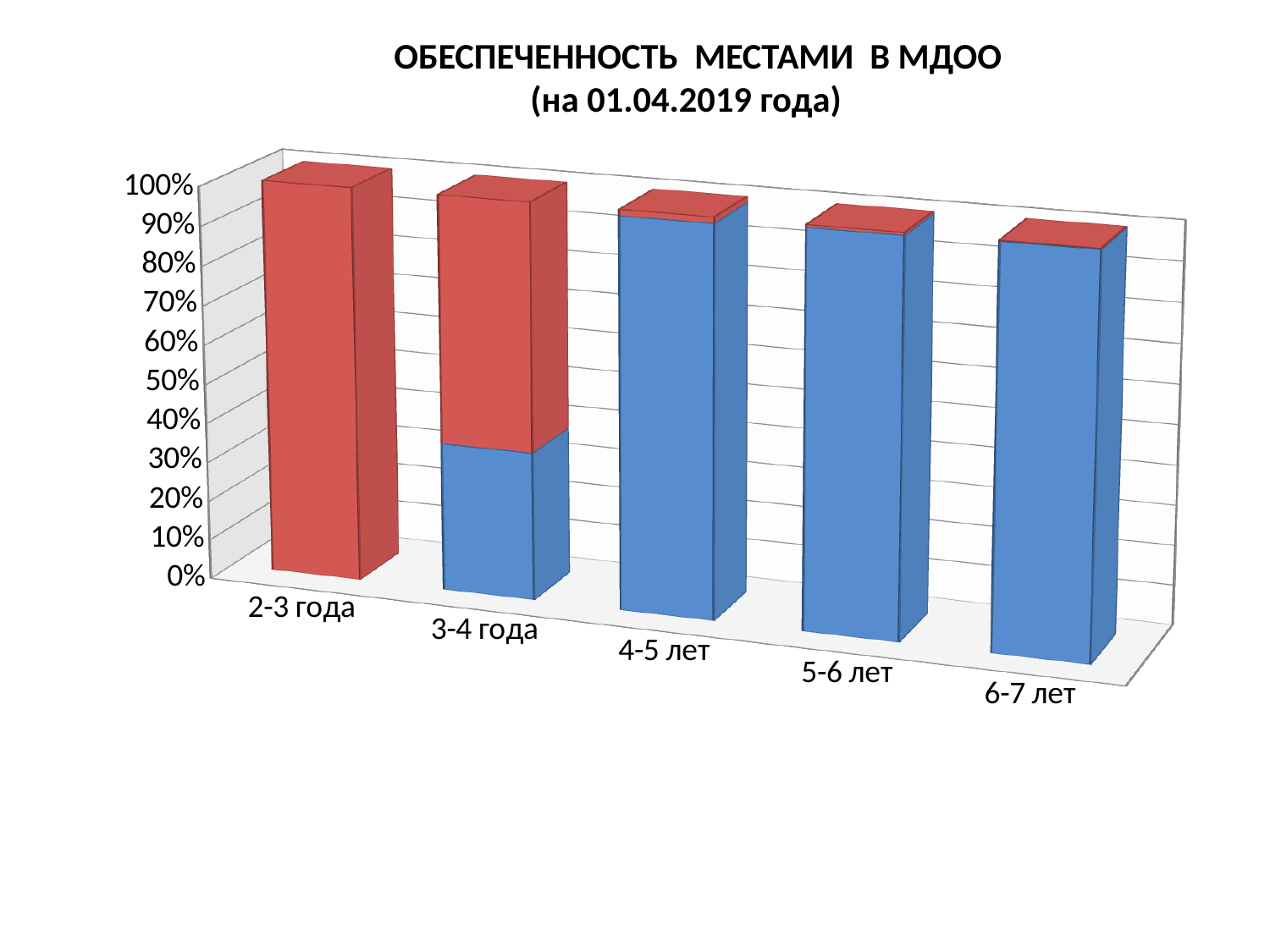
Is the blue segment for 3-4 года greater or less than 50%? less Which two colours are used for the bar segments in the chart? Red and blue Is the blue segment for 5-6 лет greater or less than 50%? greater What kind of chart is shown on the slide? Stacked bar chart Which category has the largest red segment? 2-3 года Is the red segment for 3-4 года greater or less than 50%? greater Which has the larger red segment, 2-3 года or 6-7 лет? 2-3 года How many age-group categories are shown on the x axis? 5 What is the title of the chart? ОБЕСПЕЧЕННОСТЬ МЕСТАМИ В МДОО (на 01.04.2019 года) Which has the larger blue segment, 3-4 года or 4-5 лет? 4-5 лет